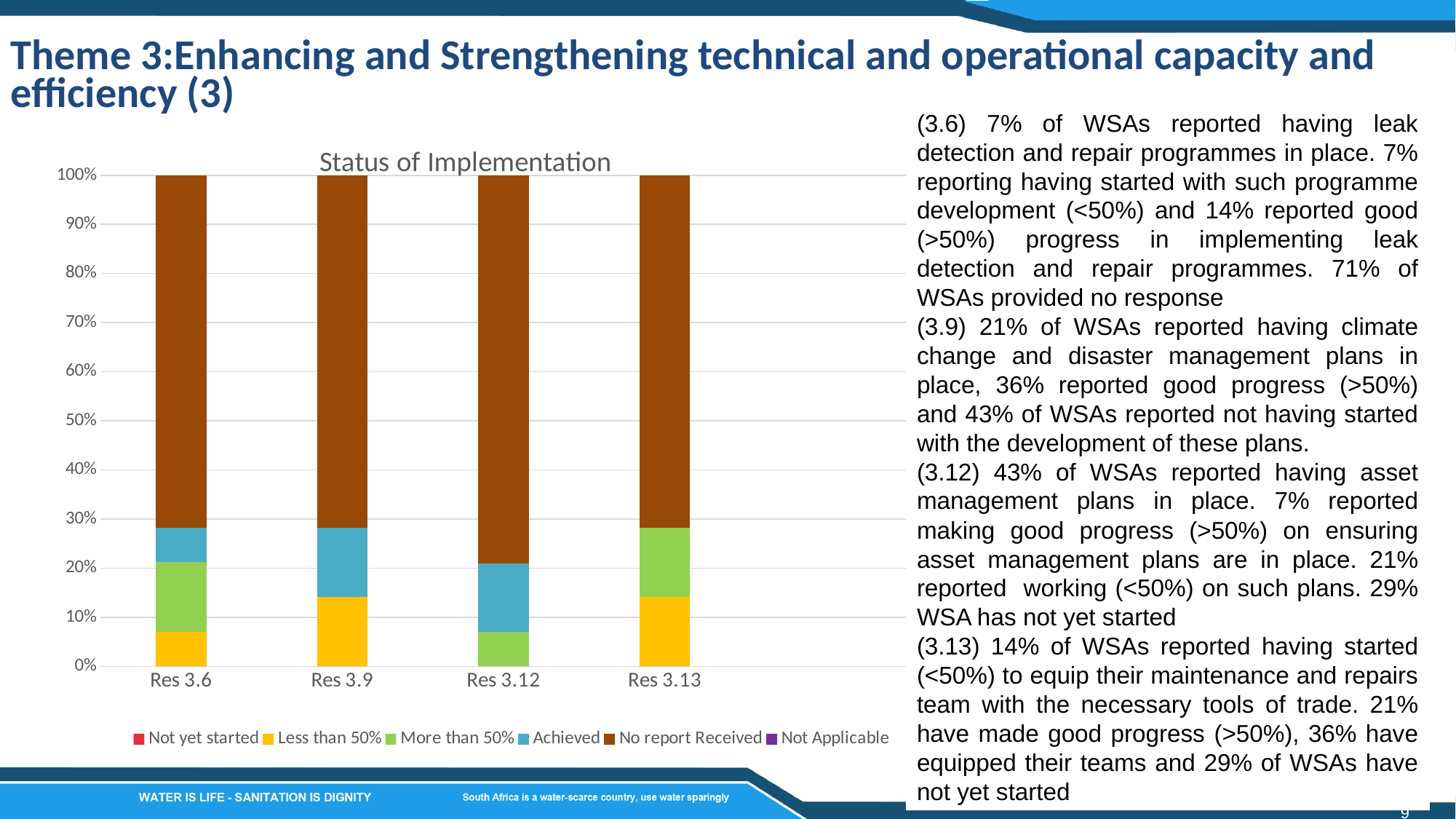
What is the total height of the stacked bar for Res 3.6? 100% How many series does the chart legend list? 6 What type of chart is shown on the slide? Stacked bar chart Is the 'No report Received' segment larger for Res 3.12 or for Res 3.6? Res 3.12 Which category has the largest 'No report Received' segment? Res 3.12 What is the title of the chart? Status of Implementation How many categories are shown on the x axis of the chart? 4 Is the 'No report Received' value for Res 3.13 greater or less than 60%? greater Is the 'Less than 50%' value for Res 3.6 greater or less than 10%? less Which series is shown in brown in the chart? No report Received Is the 'Less than 50%' value for Res 3.9 greater or less than 10%? greater